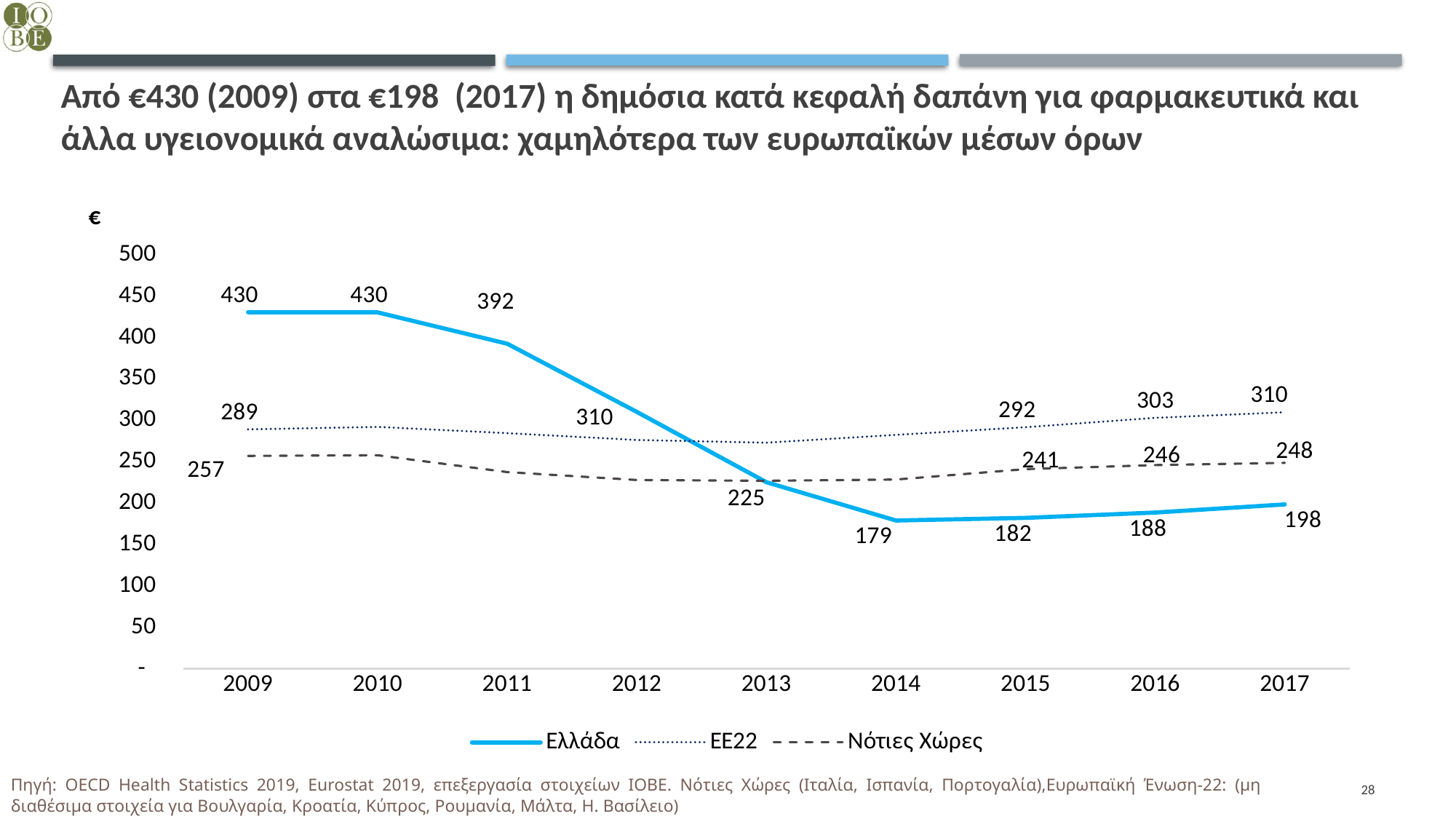
What is the value for Νότιες Χώρες in 2015? 241 What is the value for ΕΕ22 in 2016? 303 What is the value for Ελλάδα in 2014? 179 How many series does the legend list? 3 What is the difference between the Ελλάδα values in 2009 and 2017? 232 In 2017, which is larger: the value for Ελλάδα or the value for Νότιες Χώρες? Νότιες Χώρες How many years are shown on the x axis? 9 What is the value for Ελλάδα in 2017? 198 In which year is the value for Ελλάδα lowest? 2014 Does the value for Ελλάδα rise or fall from 2009 to 2014? fall What is the difference between the ΕΕ22 value and the Ελλάδα value in 2017? 112 What type of chart is shown on the slide? line chart